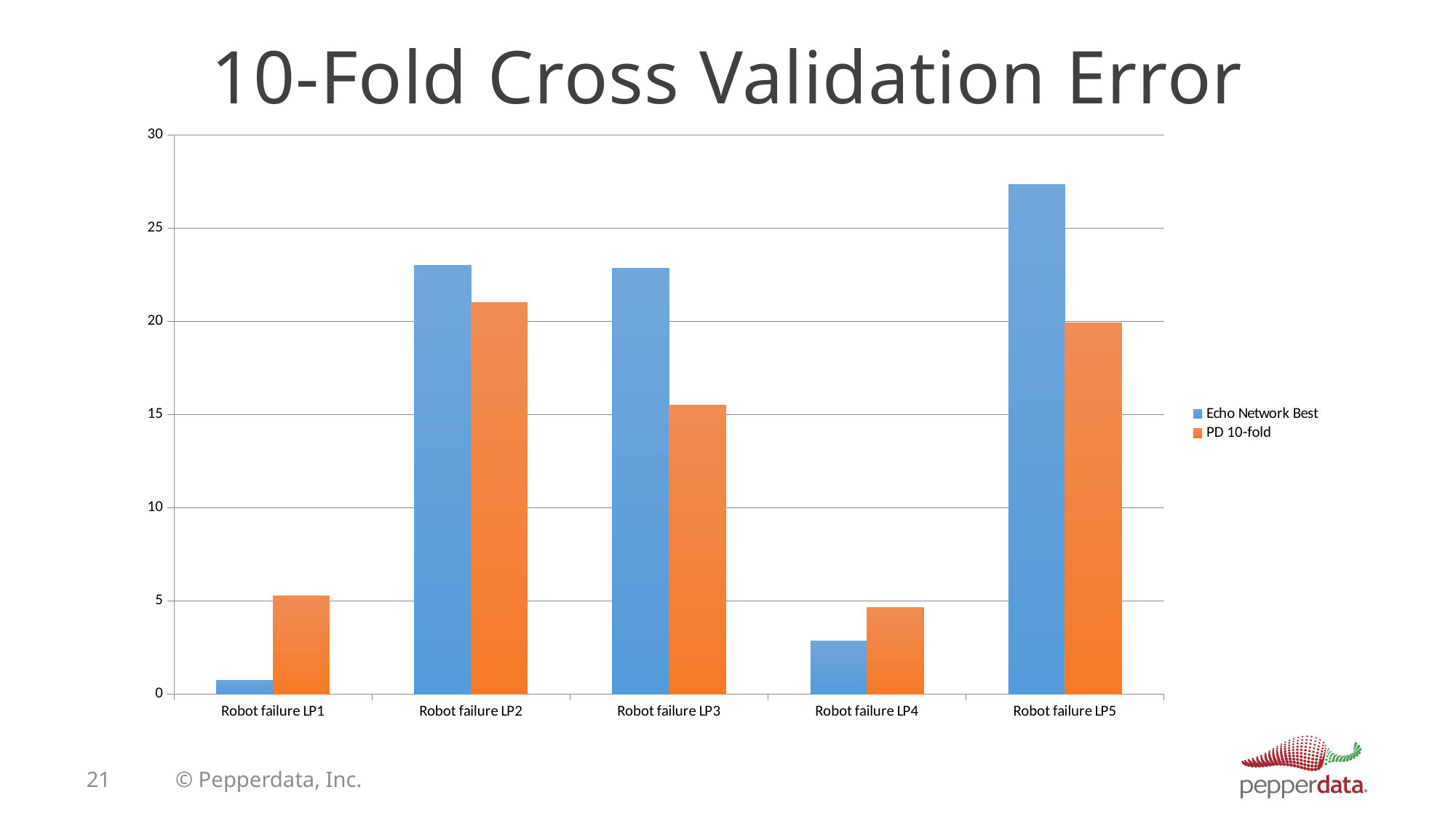
Is the Echo Network Best value for Robot failure LP5 greater or less than 25? greater How many series does the legend list? 2 Which category has the lowest Echo Network Best value? Robot failure LP1 Is the PD 10-fold value for Robot failure LP3 greater or less than 20? less For Robot failure LP3, which series has the larger value, Echo Network Best or PD 10-fold? Echo Network Best How many categories are shown on the x axis? 5 For Robot failure LP1, which series has the larger value, Echo Network Best or PD 10-fold? PD 10-fold What kind of chart is shown on the slide? bar chart Which category has the highest PD 10-fold value? Robot failure LP2 What is the title of the chart? 10-Fold Cross Validation Error Which category has the highest Echo Network Best value? Robot failure LP5 Is the Echo Network Best value for Robot failure LP4 greater or less than 5? less